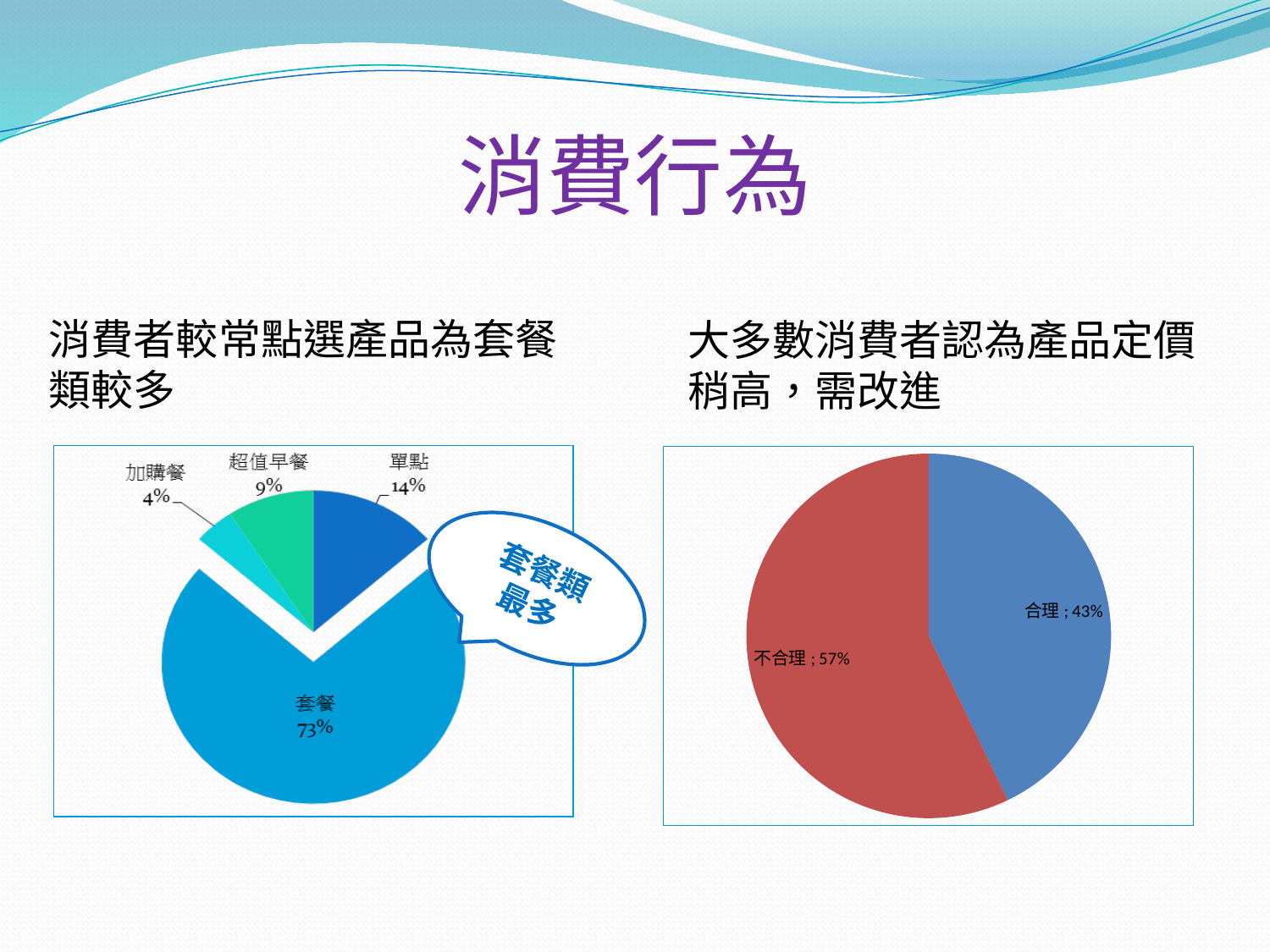
In the left pie chart, which category has the smallest share? 加購餐 In the right pie chart, which is larger, 合理 or 不合理? 不合理 In the right pie chart, what is the difference between the shares of 不合理 and 合理? 14% What kind of chart is the chart on the right? Pie chart In the left pie chart, which category has the largest share? 套餐 How many categories does the left pie chart show? 4 In the left pie chart, what share does 套餐 have? 73% In the right pie chart, what share does 合理 have? 43% In the right pie chart, what share does 不合理 have? 57% In the left pie chart, what share does 加購餐 have? 4% In the left pie chart, what is the difference between the shares of 單點 and 超值早餐? 5% In the left pie chart, what share does 單點 have? 14%